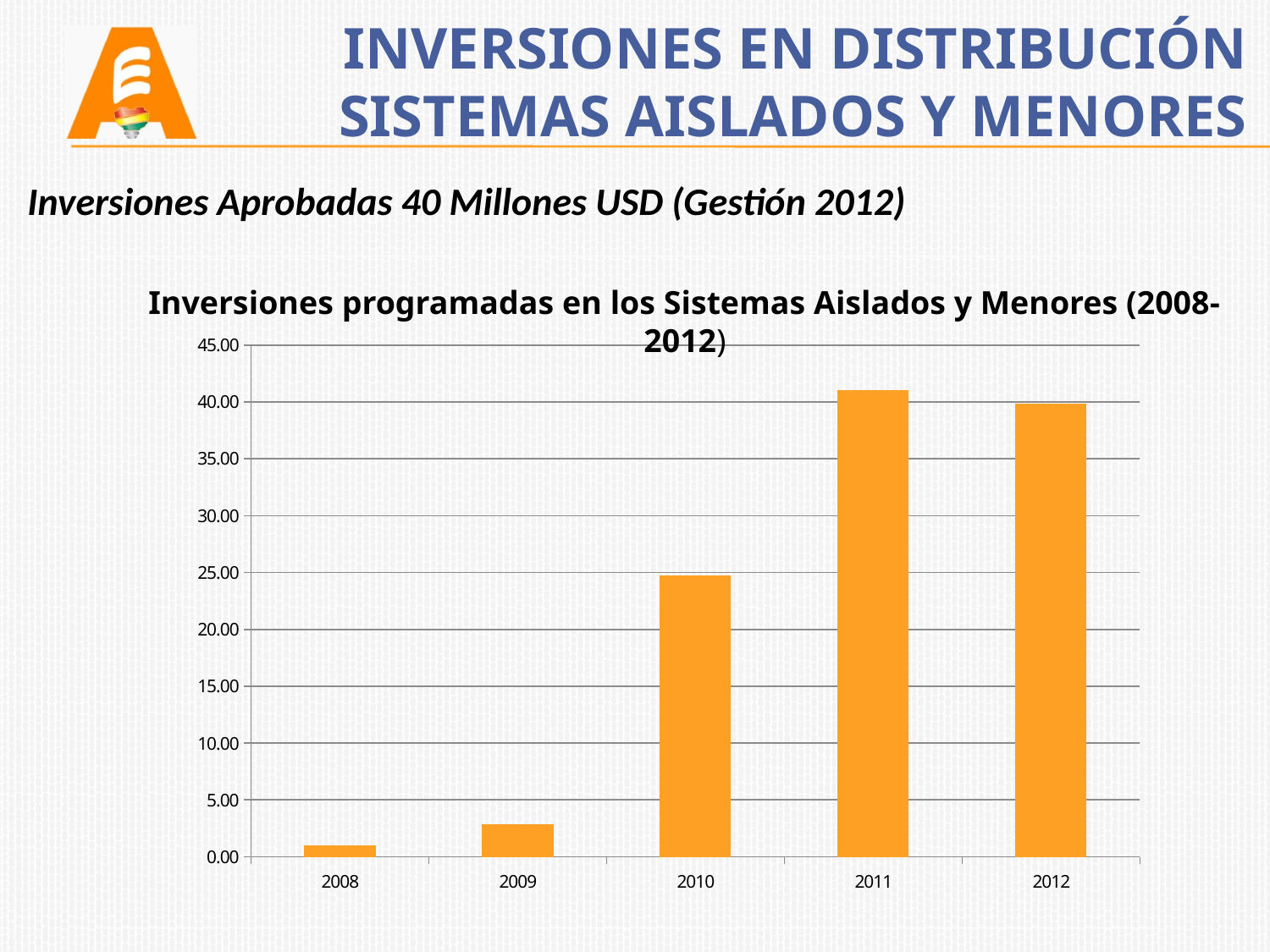
Do the values generally rise or fall from 2008 to 2011? rise Which year has the highest value in the chart? 2011 Is the value for 2009 greater or less than 5.00? less Is the value for 2010 greater or less than 20.00? greater What is the title of the chart? Inversiones programadas en los Sistemas Aislados y Menores (2008-2012) How many years are shown on the x axis of the chart? 5 Which is larger, the value for 2010 or the value for 2009? 2010 Which year has the lowest value in the chart? 2008 Is the value for 2008 greater or less than 5.00? less What kind of chart is shown on the slide? bar chart